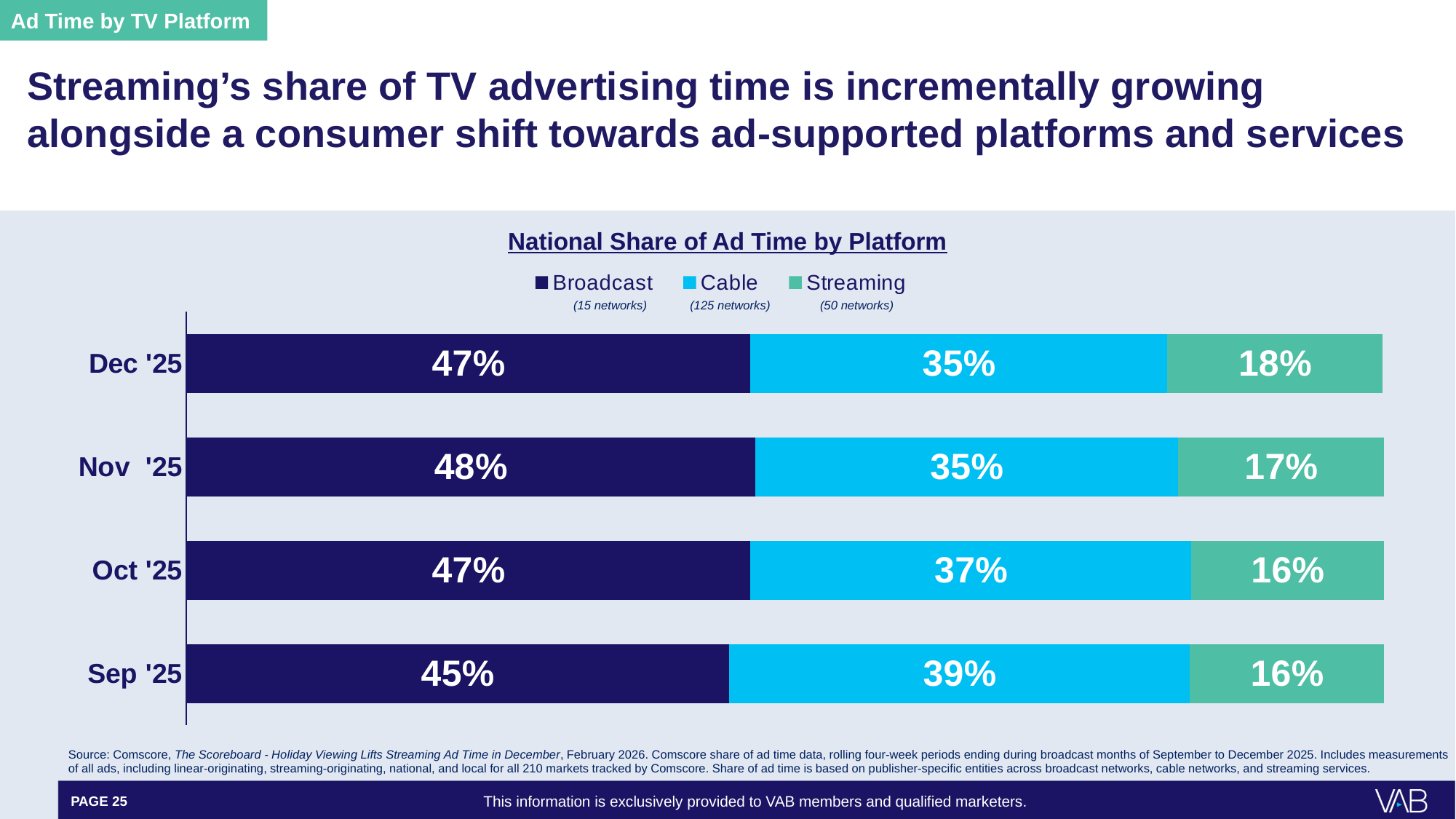
Which month has the highest Streaming share of ad time? Dec '25 How many months are shown on the chart? 4 How many series does the legend list? 3 Which is larger in Oct '25: the Cable share or the Streaming share? Cable What kind of chart is shown on the slide? Stacked bar chart What is the title of the chart? National Share of Ad Time by Platform What is the difference between the Cable share in Sep '25 and the Cable share in Dec '25? 4 percentage points What is the total of the three shares for the Nov '25 bar? 100% What is the Broadcast share of ad time for Dec '25? 47% What is the Cable share of ad time for Sep '25? 39% Which month has the lowest Broadcast share of ad time? Sep '25 What is the Streaming share of ad time for Nov '25? 17%